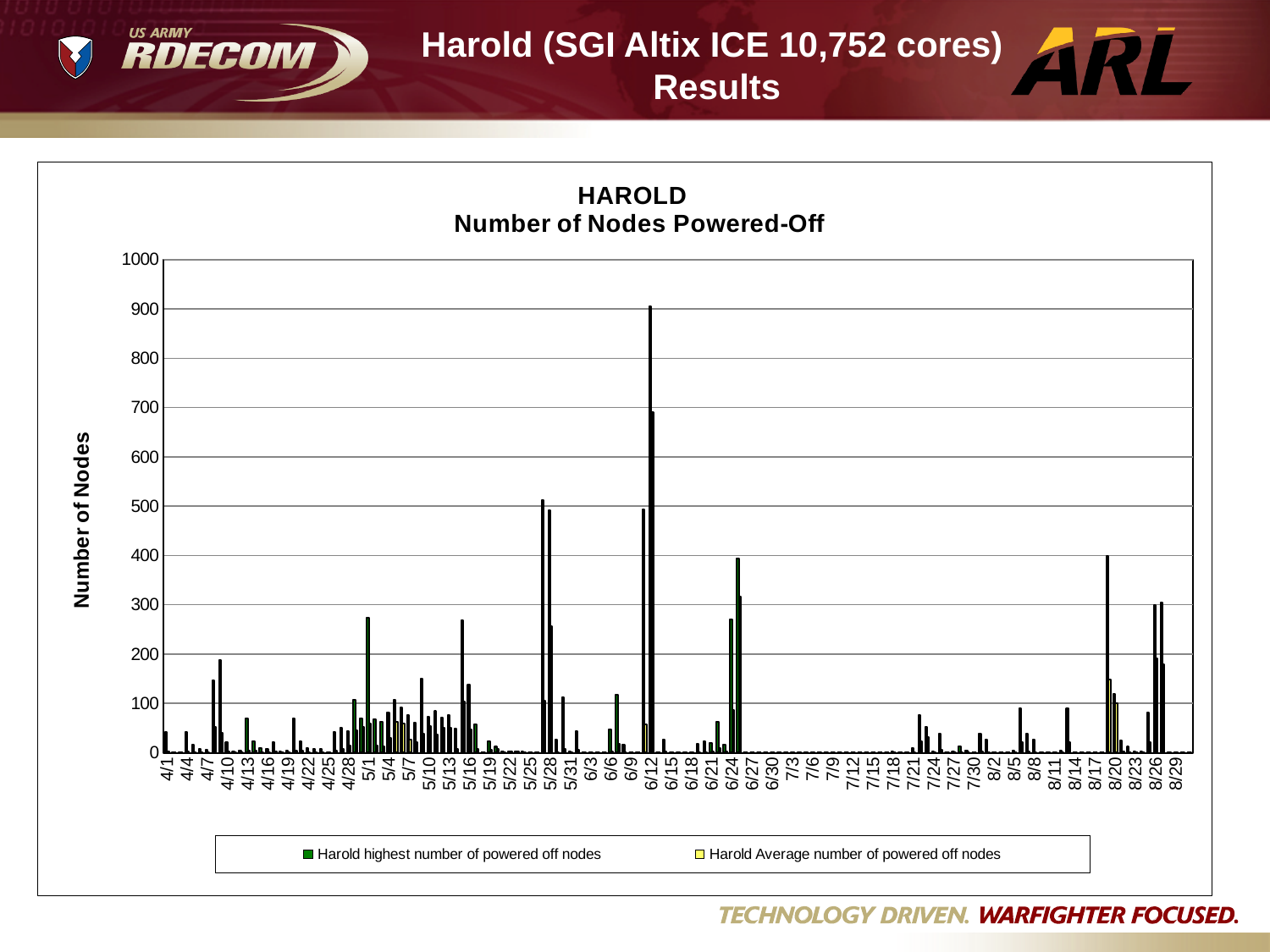
Is the value for 7/6 greater or less than 100? less What is the title of the chart? HAROLD Number of Nodes Powered-Off Is the value for 4/1 greater or less than 100? less How many series does the legend list? 2 Which is taller, the tallest bar around 6/12 or the tallest bar around 5/28? 6/12 Is the tallest bar around 6/24 greater or less than 300? greater What is the label on the vertical axis? Number of Nodes In which month does the tallest bar on the chart occur? June What kind of chart is shown on the slide? bar chart